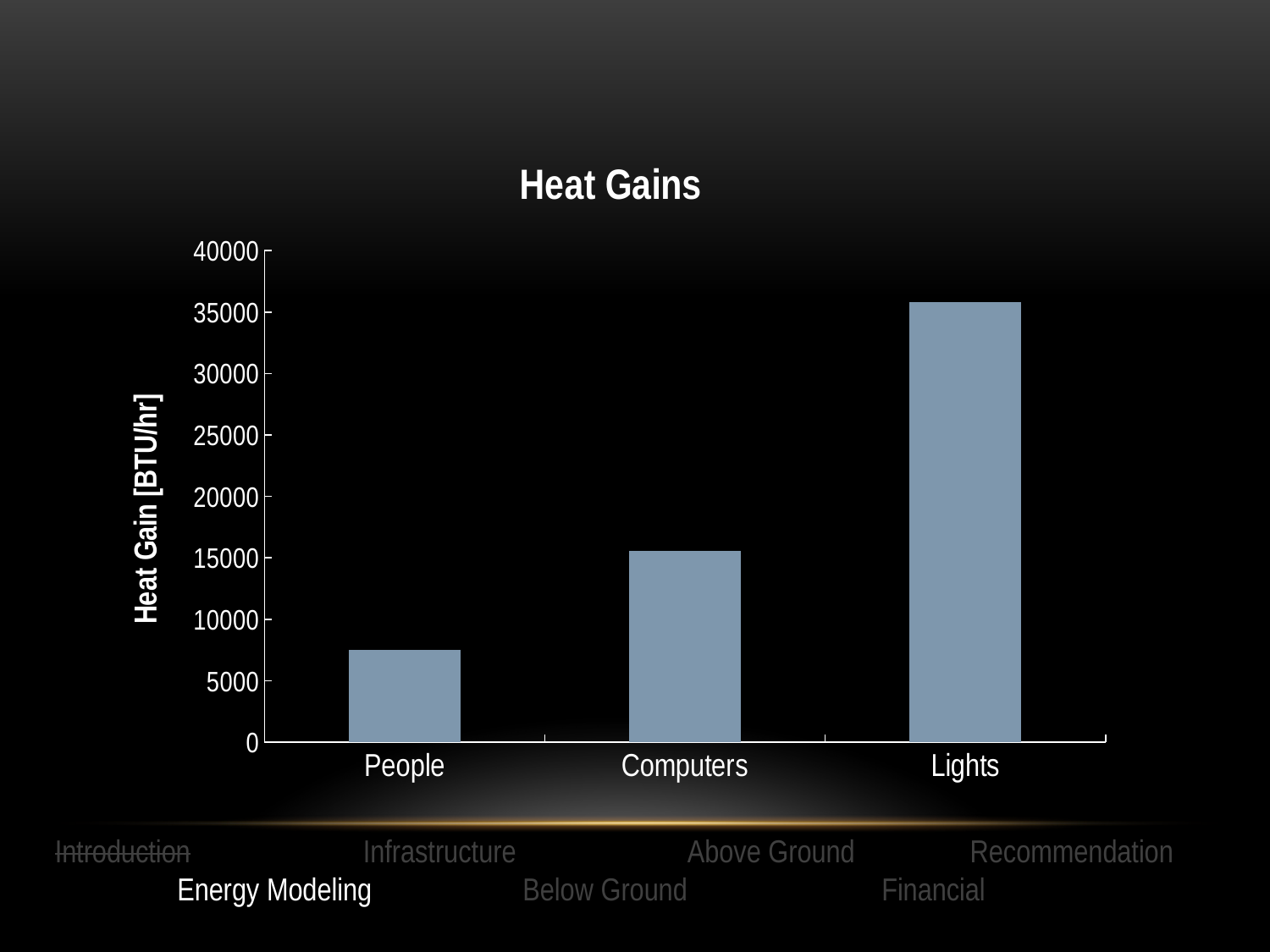
Which has a larger heat gain, Computers or People? Computers What is the label on the vertical axis of the chart? Heat Gain [BTU/hr] Which category has the lowest heat gain? People Which has a larger heat gain, Lights or Computers? Lights How many categories are shown on the x axis of the chart? 3 Is the value for Computers greater or less than 20000? less Which category has the highest heat gain? Lights Is the value for Lights greater or less than 30000? greater Is the value for People greater or less than 10000? less What is the title of the chart? Heat Gains Do the values rise or fall moving from People to Lights along the x axis? rise What type of chart is shown on the slide? bar chart